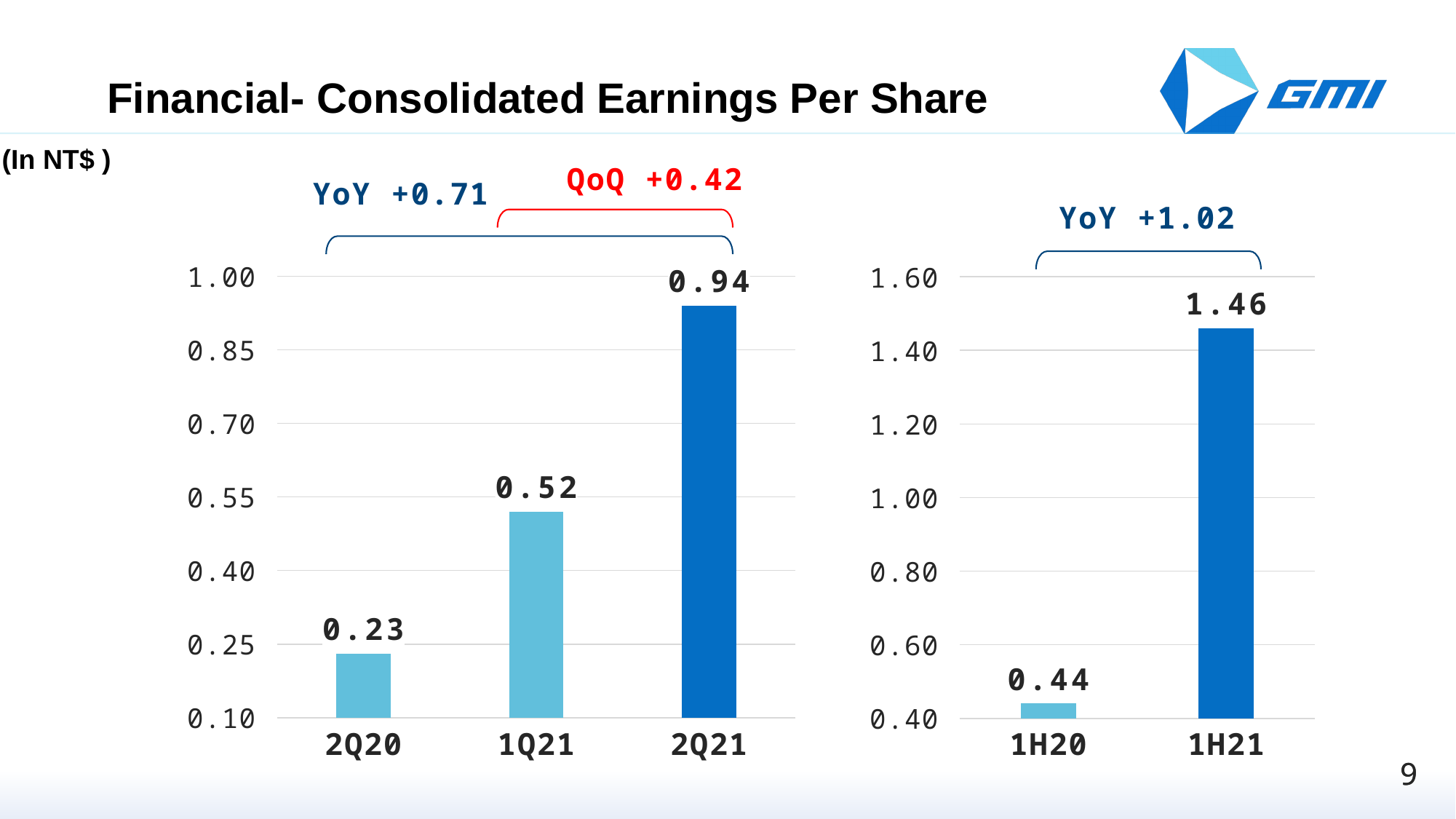
In the left chart (quarterly EPS), what is the value for 2Q20? 0.23 In the left chart (quarterly EPS), what is the difference between 2Q21 and 1Q21? 0.42 In the left chart (quarterly EPS), what is the value for 2Q21? 0.94 In the right chart (half-year EPS), what is the difference between 1H21 and 1H20? 1.02 In the left chart (quarterly EPS), which quarter has the lowest value? 2Q20 In the left chart (quarterly EPS), do the values rise or fall from 2Q20 to 2Q21? Rise In the right chart (half-year EPS), what is the value for 1H21? 1.46 How many categories are shown in the left chart (quarterly EPS)? 3 What kind of chart is the right chart (half-year EPS)? Bar chart In the left chart (quarterly EPS), which quarter has the highest value? 2Q21 In the right chart (half-year EPS), what is the value for 1H20? 0.44 In the left chart (quarterly EPS), which is larger, 1Q21 or 2Q20? 1Q21